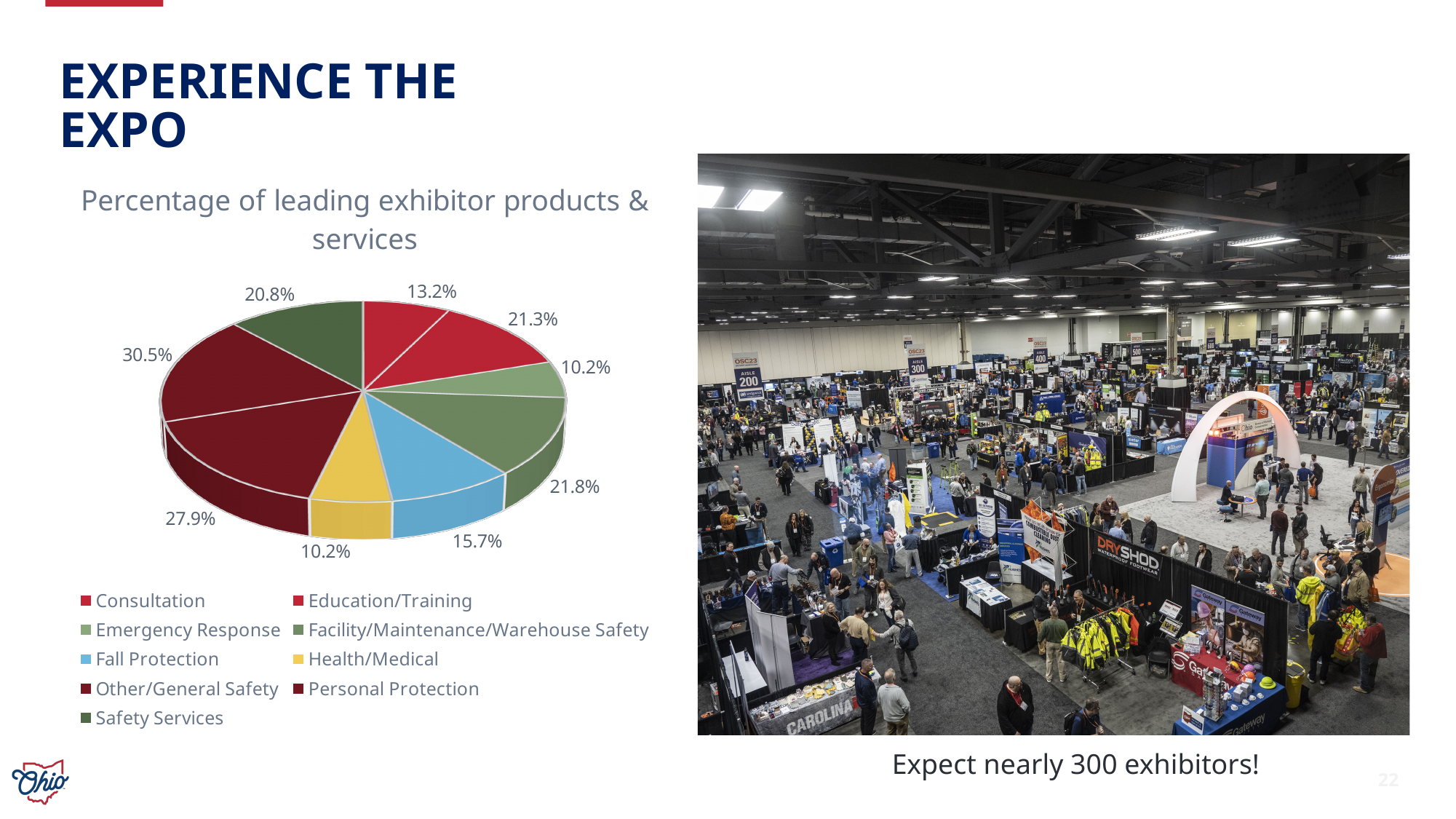
What is the value shown for Emergency Response? 10.2% What is the value shown for Facility/Maintenance/Warehouse Safety? 21.8% What kind of chart is shown on the slide? pie chart What is the value shown for Fall Protection? 15.7% What is the smallest percentage labelled on the pie chart? 10.2% How many categories does the chart's legend list? 9 What is the title of the chart? Percentage of leading exhibitor products & services Which is larger, the value for Fall Protection or the value for Health/Medical? Fall Protection What is the largest percentage labelled on the pie chart? 30.5% What is the value shown for Safety Services? 20.8% What is the difference between the values for Facility/Maintenance/Warehouse Safety and Fall Protection? 6.1 percentage points What is the value shown for Health/Medical? 10.2%